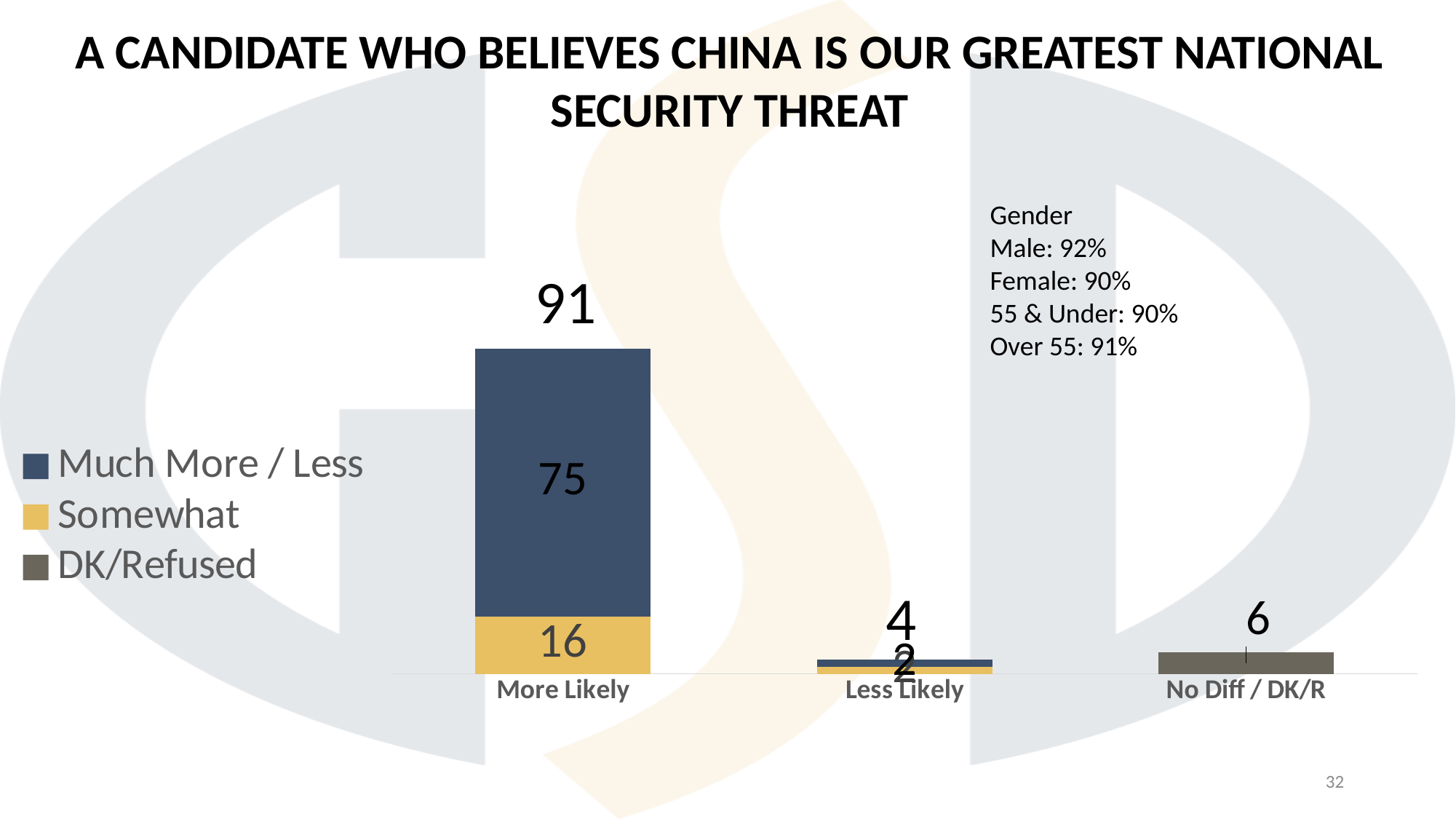
What is the total of the stacked bar for More Likely? 91 Which category has the lowest total? Less Likely What is the value of the Much More / Less segment for More Likely? 75 How many series does the legend list? 3 What is the value of the Somewhat segment for More Likely? 16 What is the total of the stacked bar for Less Likely? 4 What kind of chart is shown on the slide? Stacked bar chart What is the difference between the More Likely total and the No Diff / DK/R value? 85 Which category has the highest total? More Likely What is the difference between the Much More / Less and Somewhat segments for More Likely? 59 What is the value shown for No Diff / DK/R? 6 How many categories are shown on the x axis? 3